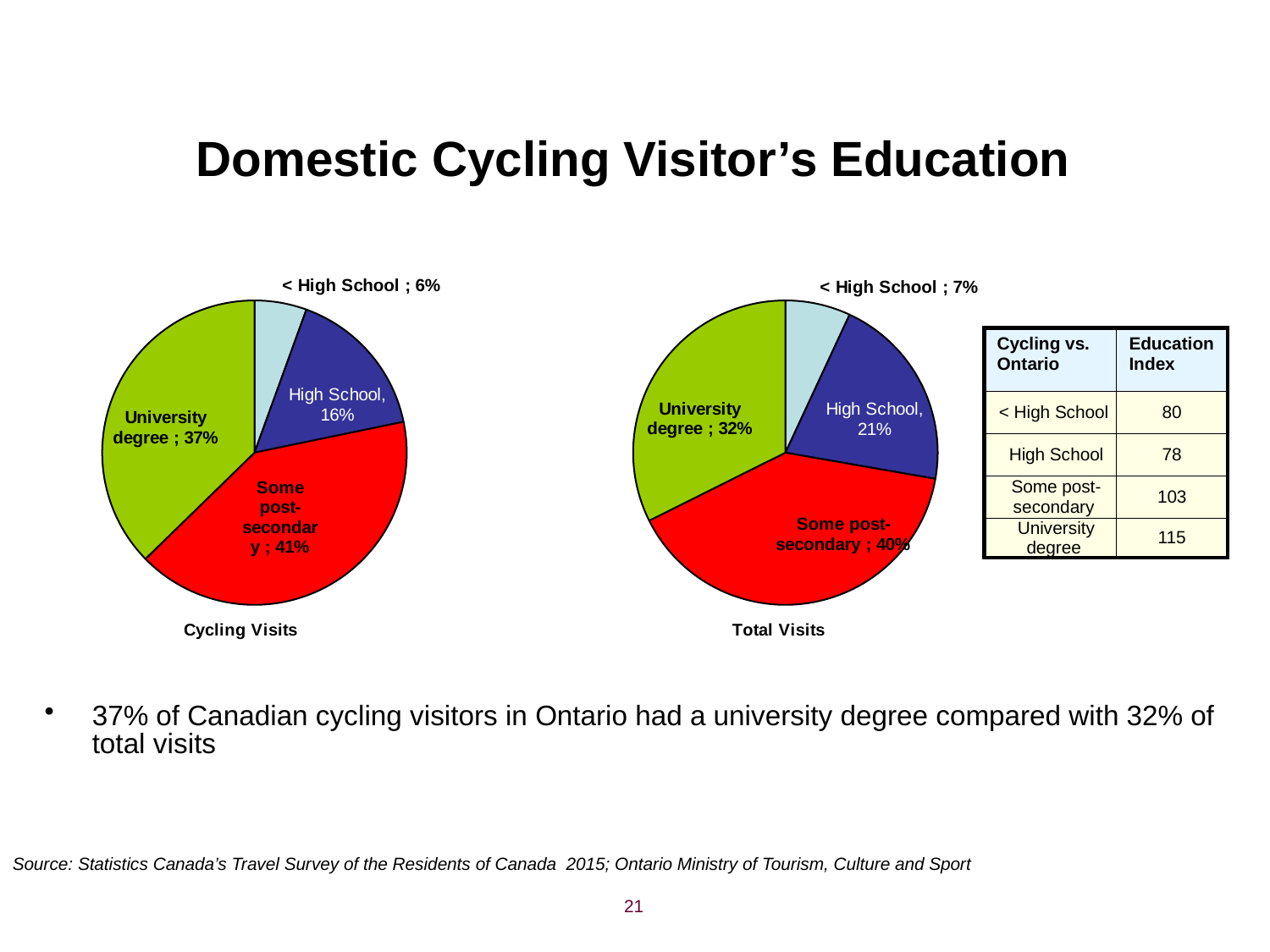
In the Total Visits pie chart, what share of visits had a university degree? 32% What is the difference between the university degree share in the Cycling Visits chart and in the Total Visits chart? 5 percentage points In the Total Visits pie chart, what share of visits had high school education? 21% In the Cycling Visits pie chart, what is the combined share of visitors with a university degree or some post-secondary education? 78% In the Cycling Visits pie chart, what share of visitors had some post-secondary education? 41% How many education categories are shown in the Cycling Visits pie chart? 4 In the Cycling Visits pie chart, what share of visitors had less than high school education? 6% What type of chart is used to show the Total Visits education breakdown? Pie chart Which is larger: the high school share in the Cycling Visits chart or in the Total Visits chart? Total Visits In the Cycling Visits pie chart, which education category has the largest share? Some post-secondary In the Cycling Visits pie chart, what colour is the University degree slice? Green In the Total Visits pie chart, which education category has the smallest share? < High School